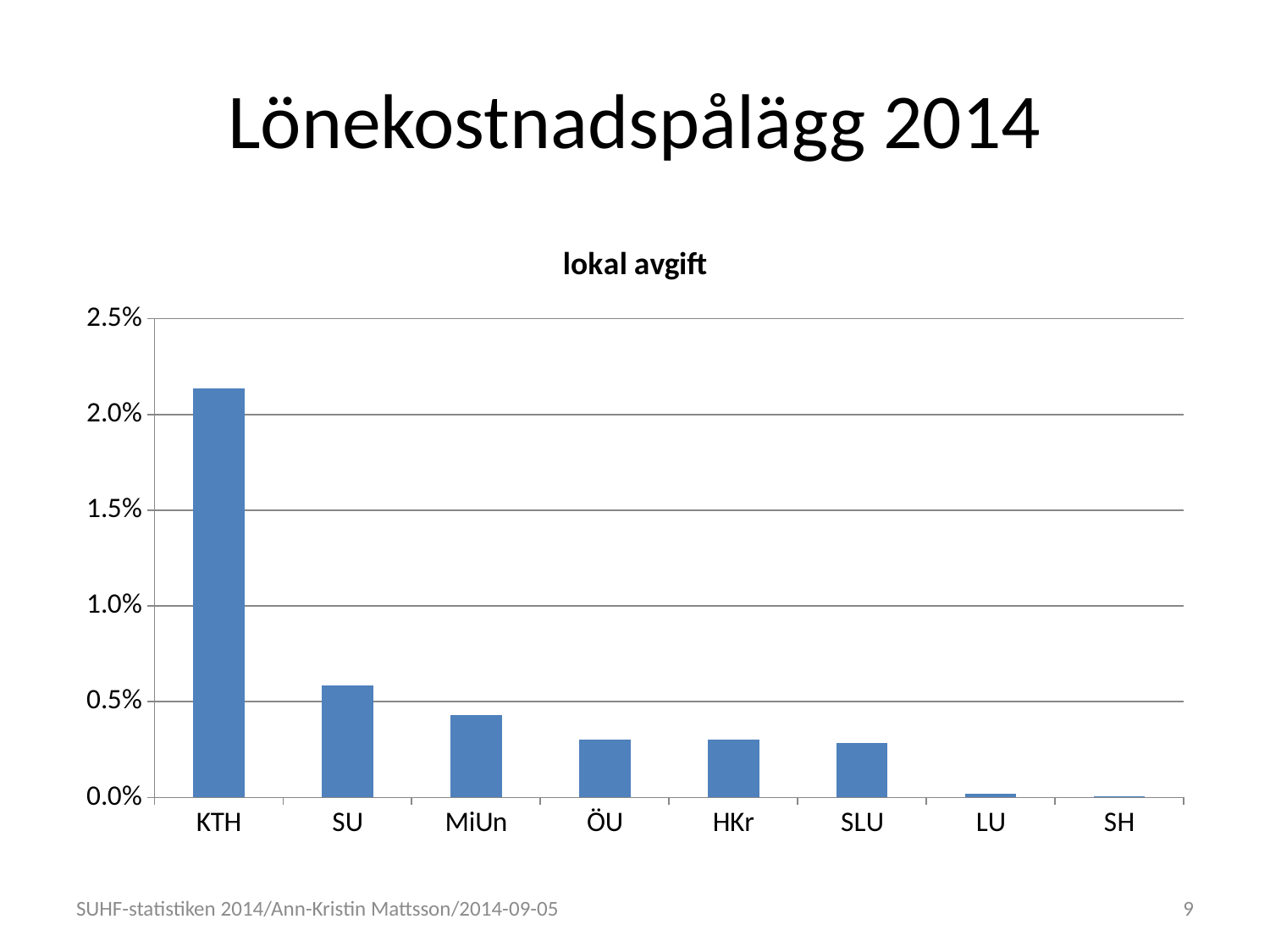
What is the title of the chart? lokal avgift How many categories are shown on the x axis? 8 Is the value for MiUn greater or less than 0.5%? less What type of chart is shown on the slide? bar chart Which is larger, the value for SU or the value for MiUn? SU Which is larger, the value for SLU or the value for LU? SLU Is the value for SU greater or less than 0.5%? greater Is the value for SLU greater or less than 0.5%? less Which category has the highest value? KTH Which is larger, the value for KTH or the value for SU? KTH Do the values rise or fall from left to right along the x axis? fall